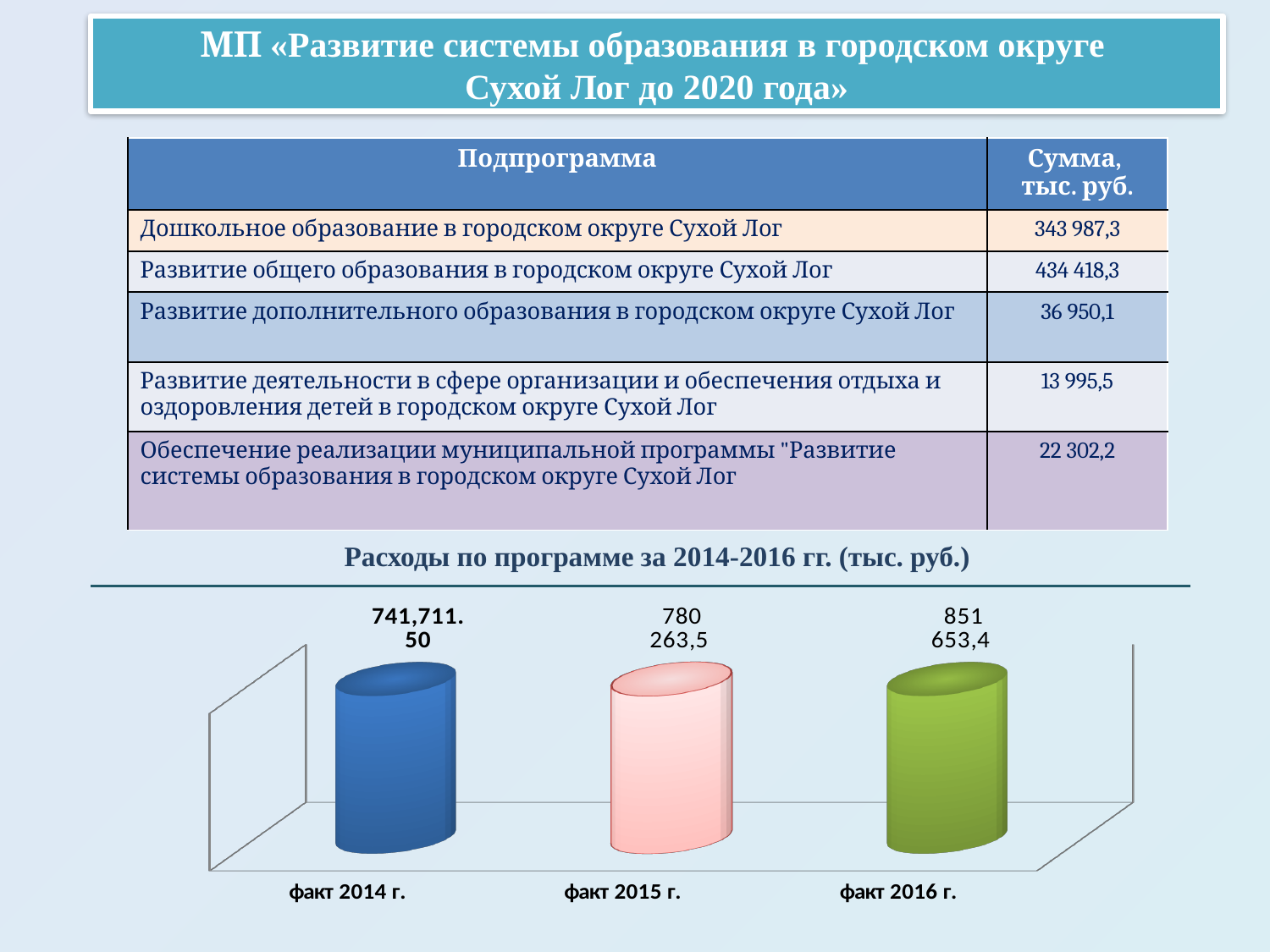
What is the title of the chart on the slide? Расходы по программе за 2014-2016 гг. (тыс. руб.) Which category has the highest value in the chart? факт 2016 г. What is the value shown for "факт 2016 г." in the chart? 851 653,4 How many categories are plotted in the chart? 3 By how much does the value for "факт 2016 г." exceed the value for "факт 2015 г." in the chart? 71 389,9 What is the value shown for "факт 2015 г." in the chart? 780 263,5 What type of chart is shown under the title "Расходы по программе за 2014-2016 гг. (тыс. руб.)"? bar chart Which is larger in the chart: the value for "факт 2015 г." or for "факт 2014 г."? факт 2015 г. Do the values in the chart rise or fall from "факт 2014 г." to "факт 2016 г."? rise What is the value shown for "факт 2014 г." in the chart? 741,711.50 What colour is the bar for "факт 2016 г." in the chart? green Which category has the lowest value in the chart? факт 2014 г.